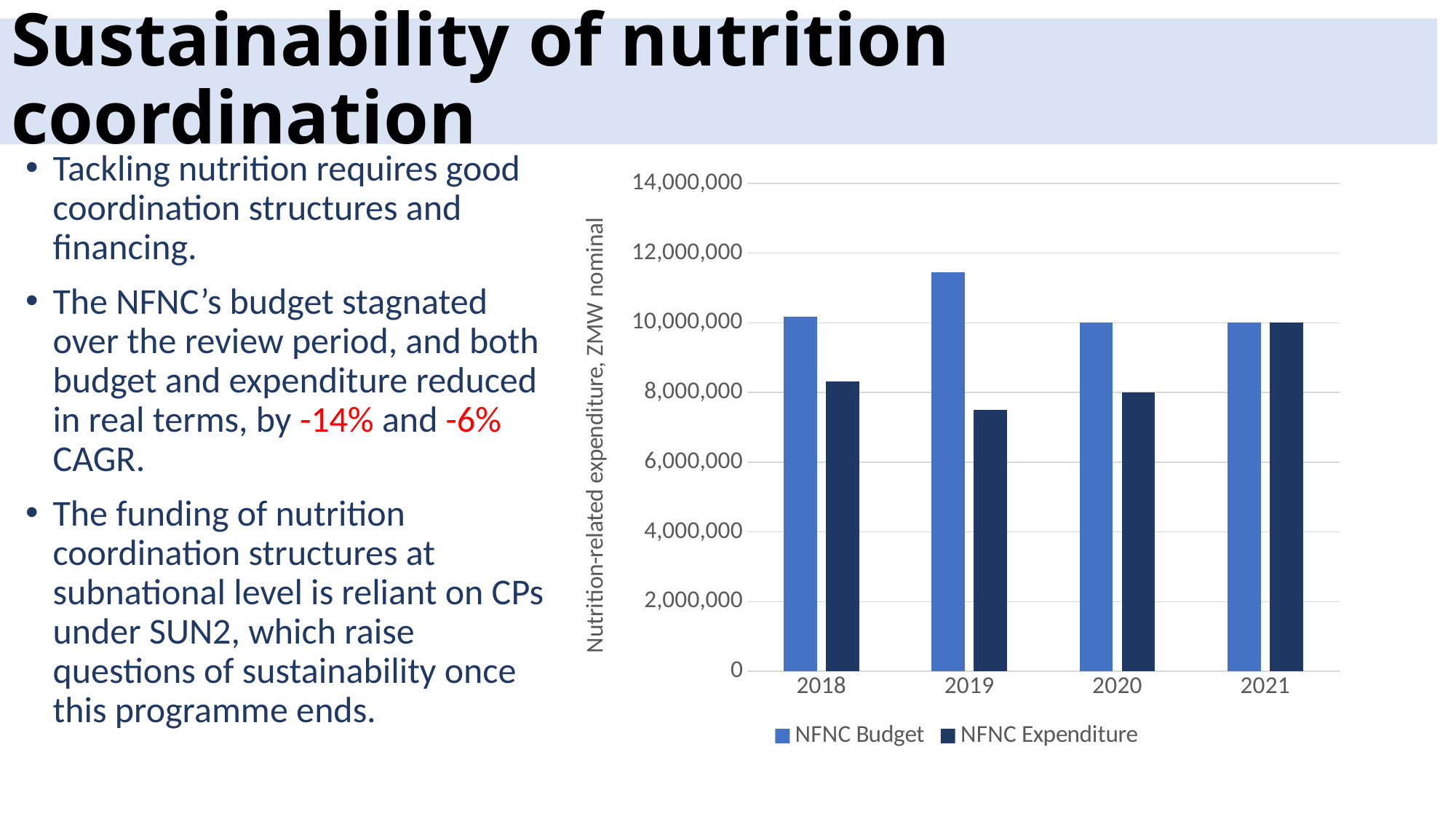
What kind of chart is shown on the slide? bar chart In which year is the NFNC Expenditure lowest? 2019 In 2018, which is larger: NFNC Budget or NFNC Expenditure? NFNC Budget Which year has the higher NFNC Expenditure, 2020 or 2021? 2021 Is the NFNC Expenditure for 2018 greater or less than 10,000,000? less Is the NFNC Budget for 2019 greater or less than 10,000,000? greater How many series does the chart's legend list? 2 Is the NFNC Expenditure for 2019 greater or less than 8,000,000? less How many years are shown on the x axis of the chart? 4 What is the title of the chart's vertical axis? Nutrition-related expenditure, ZMW nominal In which year is the NFNC Budget highest? 2019 Does the NFNC Expenditure rise or fall from 2019 to 2021? rise